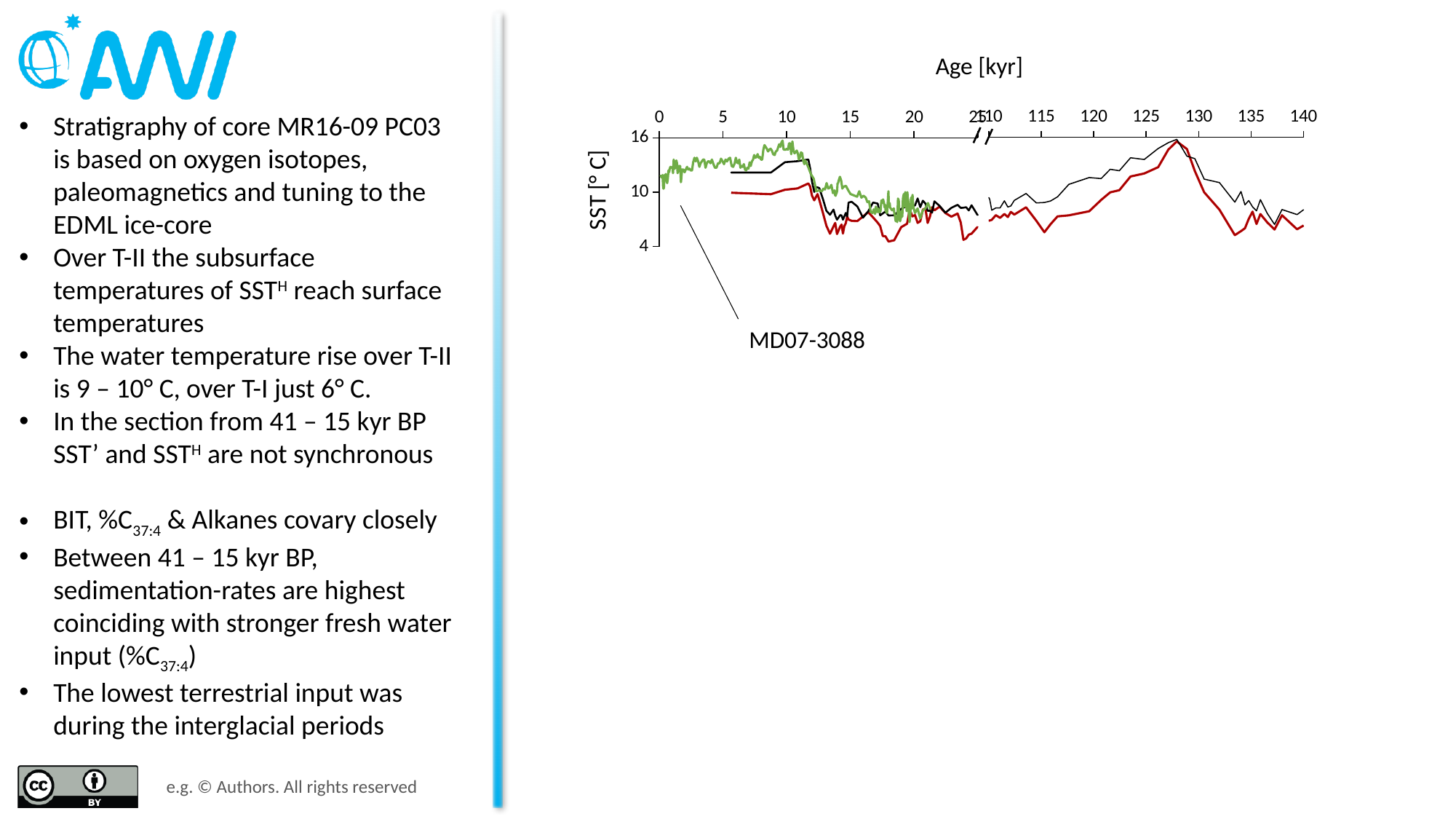
What is the highest tick value shown on the x axis of the chart? 140 Does the red line rise or fall between 110 kyr and 128 kyr? rise Is the value of the black line at 125 kyr greater or less than 10? greater What kind of chart is shown on the slide? line chart Is the value of the green line at 10 kyr greater or less than 10? greater Does the green line rise or fall between 10 kyr and 20 kyr? fall How many lines are plotted in the chart? 3 Is the value of the red line at 18 kyr greater or less than 10? less What is the label of the x axis of the chart? Age [kyr] What is the label of the y axis of the chart? SST [° C] Does the red line rise or fall between 128 kyr and 140 kyr? fall